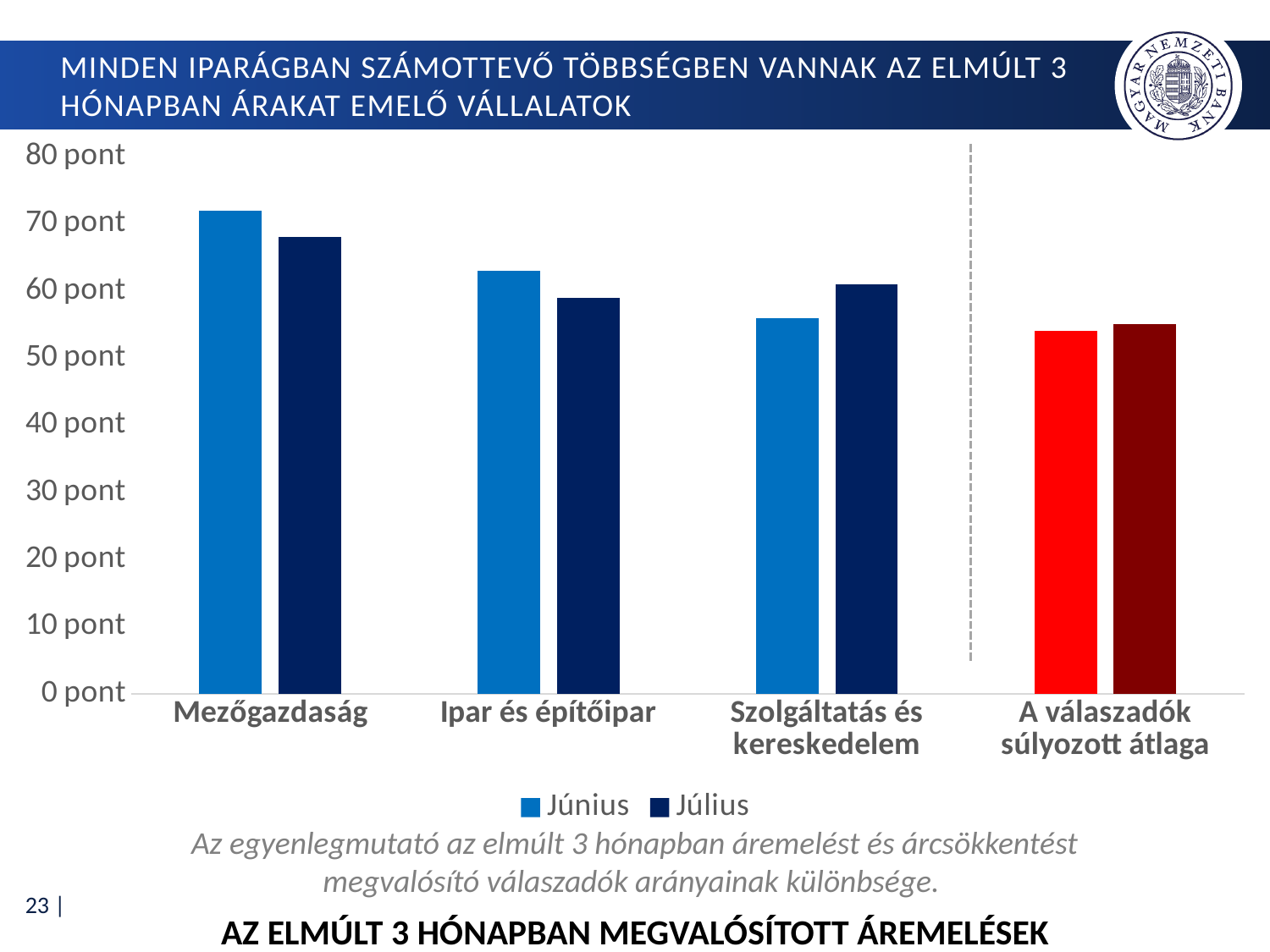
For Szolgáltatás és kereskedelem, which is larger: the Június value or the Július value? Július What are the two series names listed in the legend? Június and Július How many categories are shown on the x axis of the chart? 4 Is the Június value for Mezőgazdaság greater or less than 70 pont? greater Which category has the highest Július value? Mezőgazdaság Is the Július value for A válaszadók súlyozott átlaga greater or less than 50 pont? greater Do the Június values rise or fall from Mezőgazdaság to Szolgáltatás és kereskedelem? fall For Mezőgazdaság, which is larger: the Június value or the Július value? Június Is the Június value for Szolgáltatás és kereskedelem greater or less than 60 pont? less Which category has the highest Június value? Mezőgazdaság What kind of chart is shown on the slide? bar chart How many series does the legend list? 2